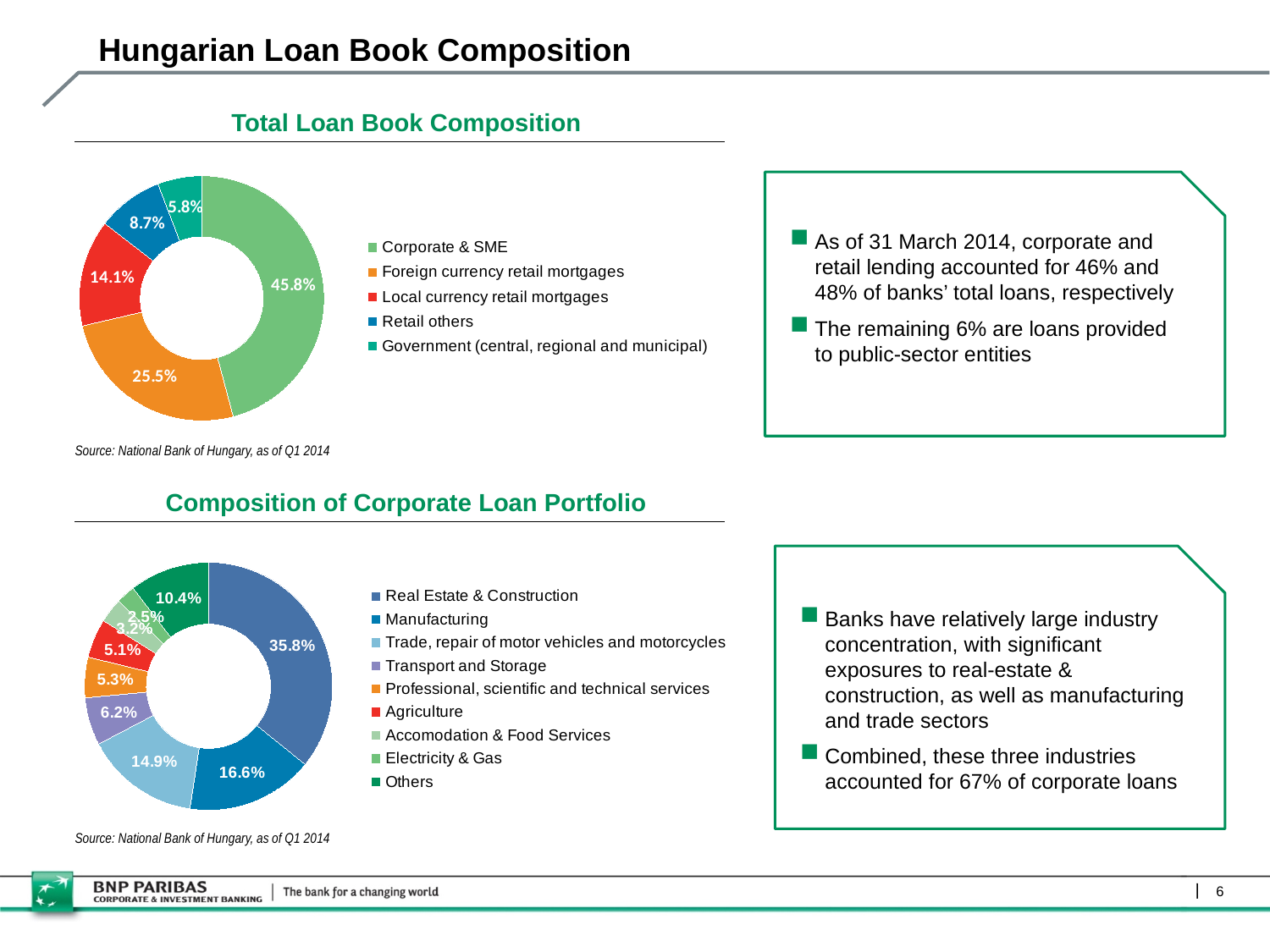
In the Total Loan Book Composition chart, which category has the smallest share? Government (central, regional and municipal) In the Total Loan Book Composition chart, what share is Corporate & SME? 45.8% In the Composition of Corporate Loan Portfolio chart, which is larger: Transport and Storage or Agriculture? Transport and Storage In the Composition of Corporate Loan Portfolio chart, what share is Real Estate & Construction? 35.8% In the Composition of Corporate Loan Portfolio chart, which category has the largest share? Real Estate & Construction In the Total Loan Book Composition chart, what share is Foreign currency retail mortgages? 25.5% In the Composition of Corporate Loan Portfolio chart, what is the difference between Manufacturing and Trade, repair of motor vehicles and motorcycles? 1.7% How many categories does the legend of the Composition of Corporate Loan Portfolio chart list? 9 How many categories does the legend of the Total Loan Book Composition chart list? 5 In the Total Loan Book Composition chart, what is the difference between Local currency retail mortgages and Retail others? 5.4% What kind of chart is the Total Loan Book Composition chart? Pie (donut) chart In the Composition of Corporate Loan Portfolio chart, what share is Manufacturing? 16.6%